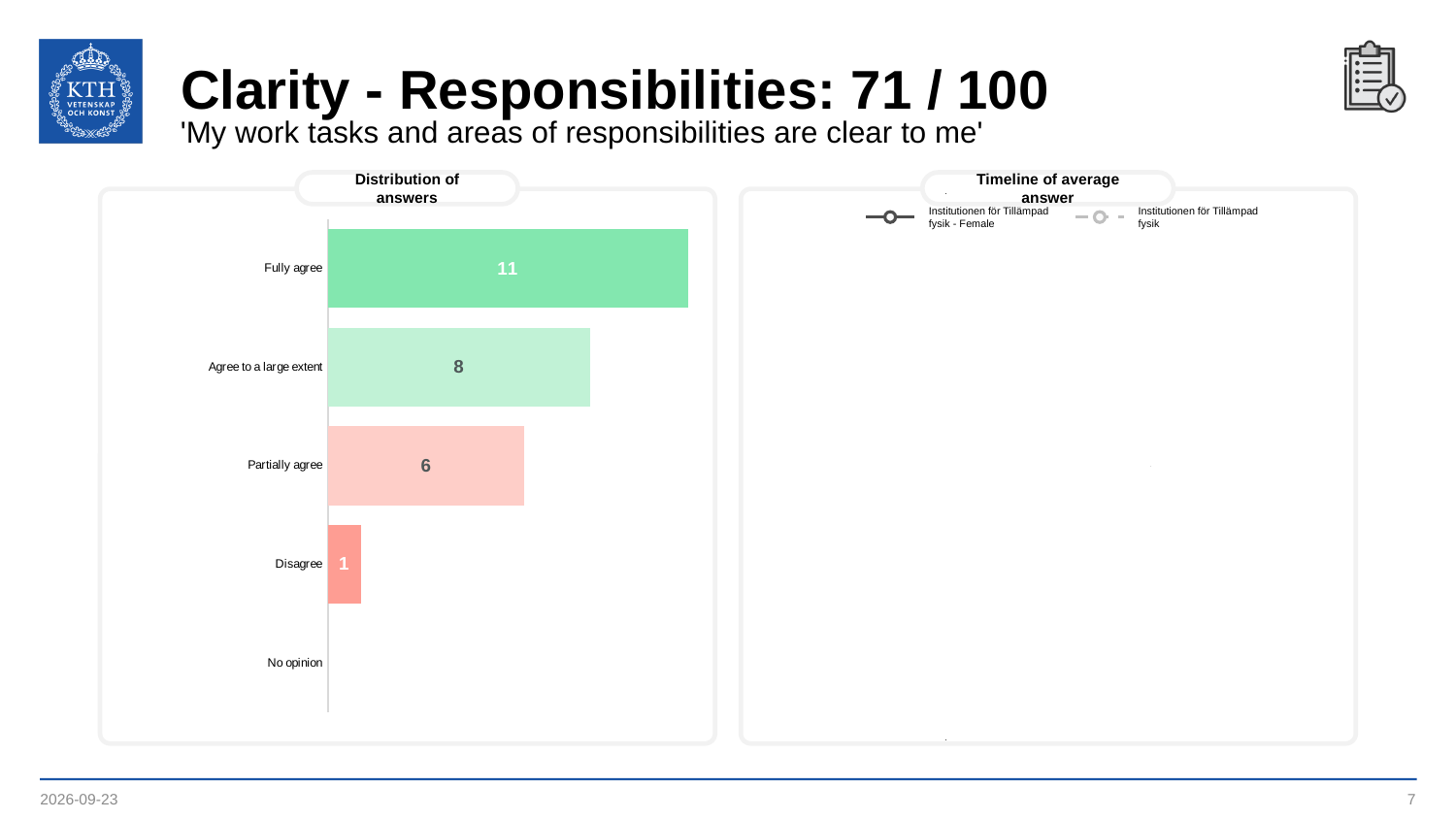
How many categories are listed on the axis of the 'Distribution of answers' chart? 5 In the 'Distribution of answers' chart, which is larger: 'Agree to a large extent' or 'Partially agree'? Agree to a large extent In the 'Distribution of answers' chart, what is the value for 'Partially agree'? 6 In the 'Distribution of answers' chart, which labelled bar has the lowest value? Disagree In the 'Distribution of answers' chart, what is the value for 'Agree to a large extent'? 8 In the 'Distribution of answers' chart, what is the difference between 'Partially agree' and 'Disagree'? 5 In the 'Distribution of answers' chart, which category has the highest value? Fully agree How many series does the legend of the 'Timeline of average answer' chart list? 2 In the 'Distribution of answers' chart, what is the difference between 'Fully agree' and 'Agree to a large extent'? 3 In the 'Distribution of answers' chart, what is the value for 'Disagree'? 1 In the 'Distribution of answers' chart, what is the value for 'Fully agree'? 11 What kind of chart is the 'Distribution of answers' chart? Bar chart